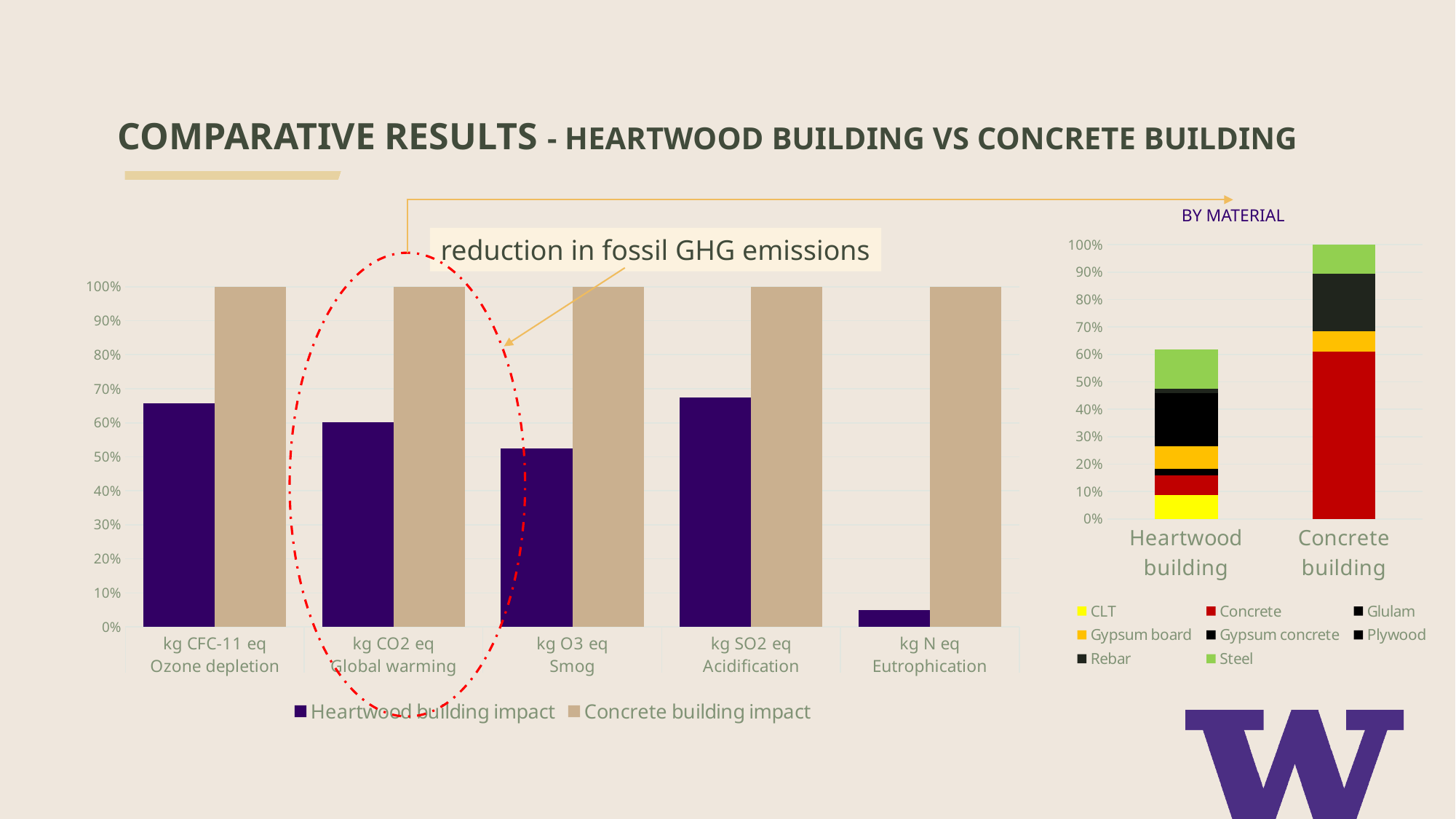
What kind of chart is the left chart comparing Heartwood building impact and Concrete building impact? bar chart In the BY MATERIAL chart on the right, which building has the taller stacked bar? Concrete building In the left chart, how many series does the legend list? 2 In the left chart, how many impact categories are shown on the x axis? 5 In the left chart, for kg SO2 eq Acidification, which is larger: Heartwood building impact or Concrete building impact? Concrete building impact In the left chart, which category has the lowest Heartwood building impact? kg N eq Eutrophication In the left chart, is the Heartwood building impact for kg O3 eq Smog greater or less than 60%? less In the left chart, is the Heartwood building impact for kg N eq Eutrophication greater or less than 10%? less In the BY MATERIAL chart on the right, how many buildings (bars) are shown? 2 In the left chart, what is the Concrete building impact value for kg CO2 eq Global warming? 100% In the BY MATERIAL chart on the right, is the total for the Heartwood building greater or less than 70%? less In the BY MATERIAL chart on the right, how many materials does the legend list? 8